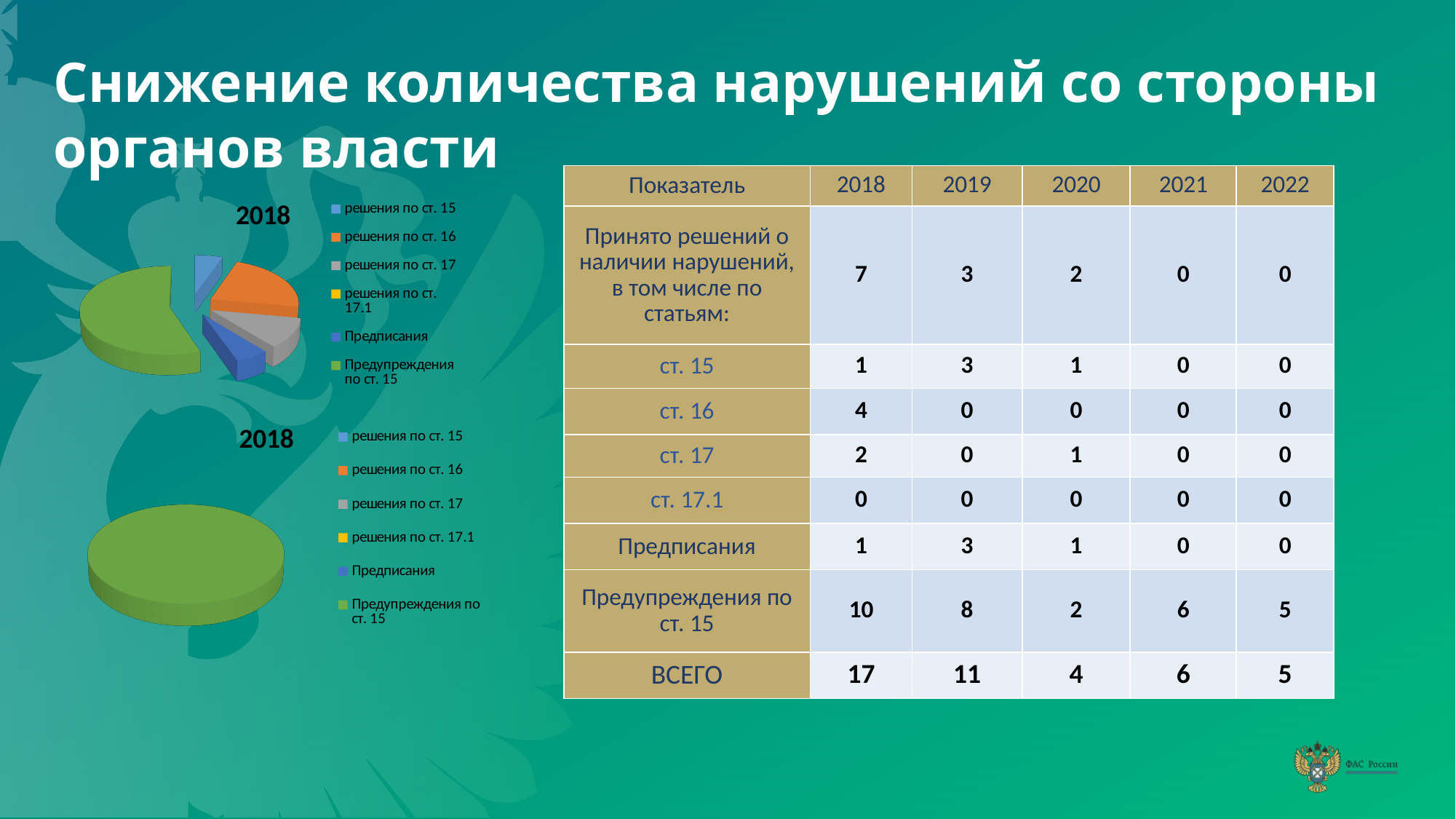
What is the title shown above the top pie chart? 2018 What kind of chart is the bottom chart on the left of the slide? pie chart In the top pie chart, which slice is larger: решения по ст. 16 or решения по ст. 15? решения по ст. 16 In the top pie chart, which slice is larger: Предупреждения по ст. 15 or решения по ст. 17? Предупреждения по ст. 15 In the bottom pie chart, which category has the largest slice? Предупреждения по ст. 15 In the top pie chart, how many entries does the legend list? 6 What kind of chart is the top chart on the left of the slide? pie chart In the top pie chart, which category has the largest slice? Предупреждения по ст. 15 In the bottom pie chart, how many entries does the legend list? 6 In the top pie chart, what colour represents Предупреждения по ст. 15? green